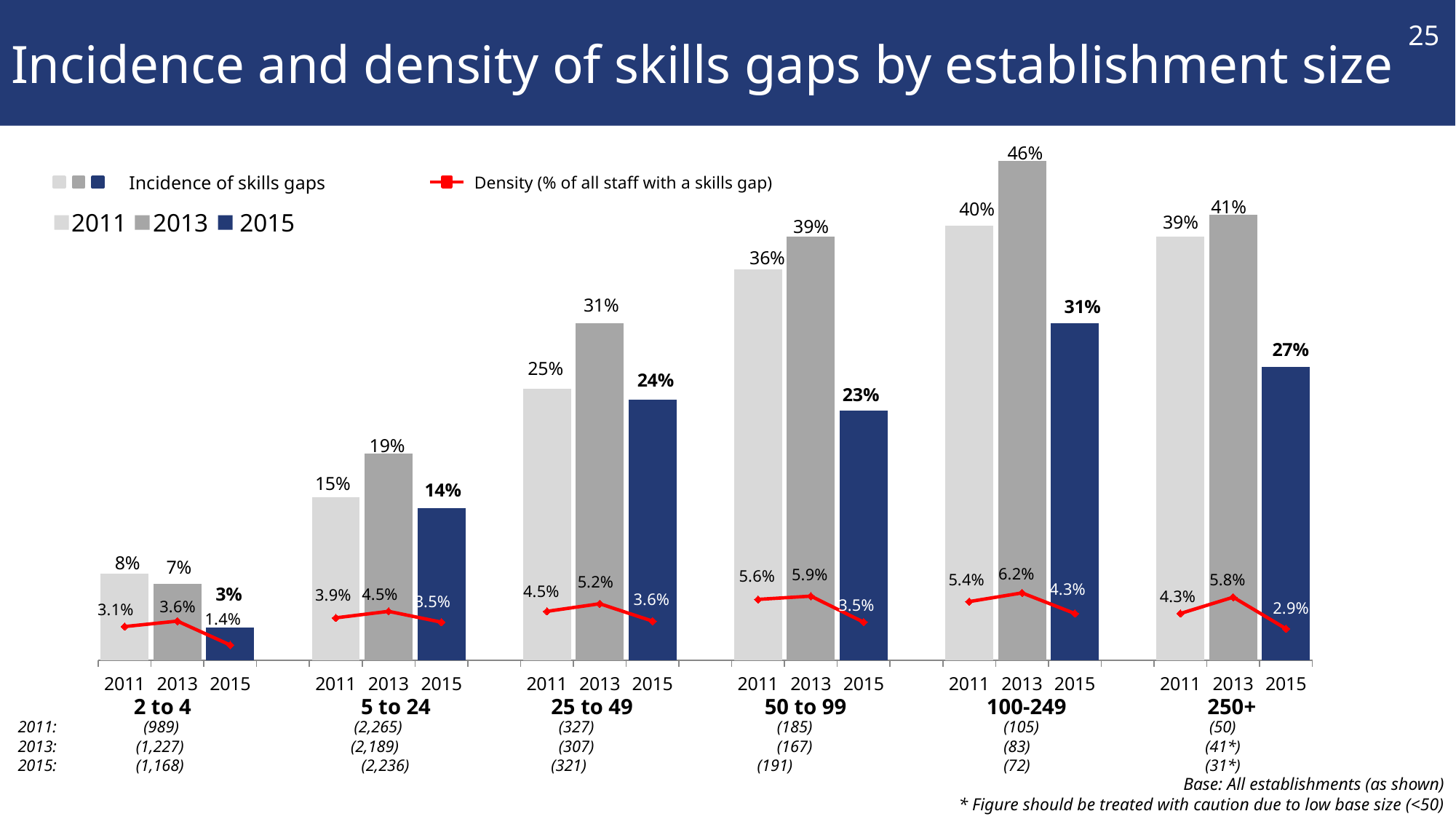
What is the incidence of skills gaps in 2015 for establishments with 100-249 staff? 31% What does the red line on the chart represent? Density (% of all staff with a skills gap) What is the density of skills gaps in 2013 for establishments with 250+ staff? 5.8% Which establishment size and year has the highest incidence of skills gaps? 100-249 in 2013 (46%) What type of chart is used to show the incidence of skills gaps? Bar chart (with a line for density) How does the density of skills gaps for establishments with 25 to 49 staff change from 2011 to 2013 to 2015? Rises from 4.5% to 5.2%, then falls to 3.6% What is the incidence of skills gaps in 2011 for establishments with 5 to 24 staff? 15% How many years does the legend list for incidence of skills gaps? 3 Which establishment size and year has the lowest density of skills gaps? 2 to 4 in 2015 (1.4%) How many establishment size groups are shown on the chart? 6 In 2011, which had a higher incidence of skills gaps: establishments with 100-249 staff or 250+ staff? 100-249 By how many percentage points did the incidence of skills gaps for establishments with 50 to 99 staff fall between 2013 and 2015? 16 percentage points